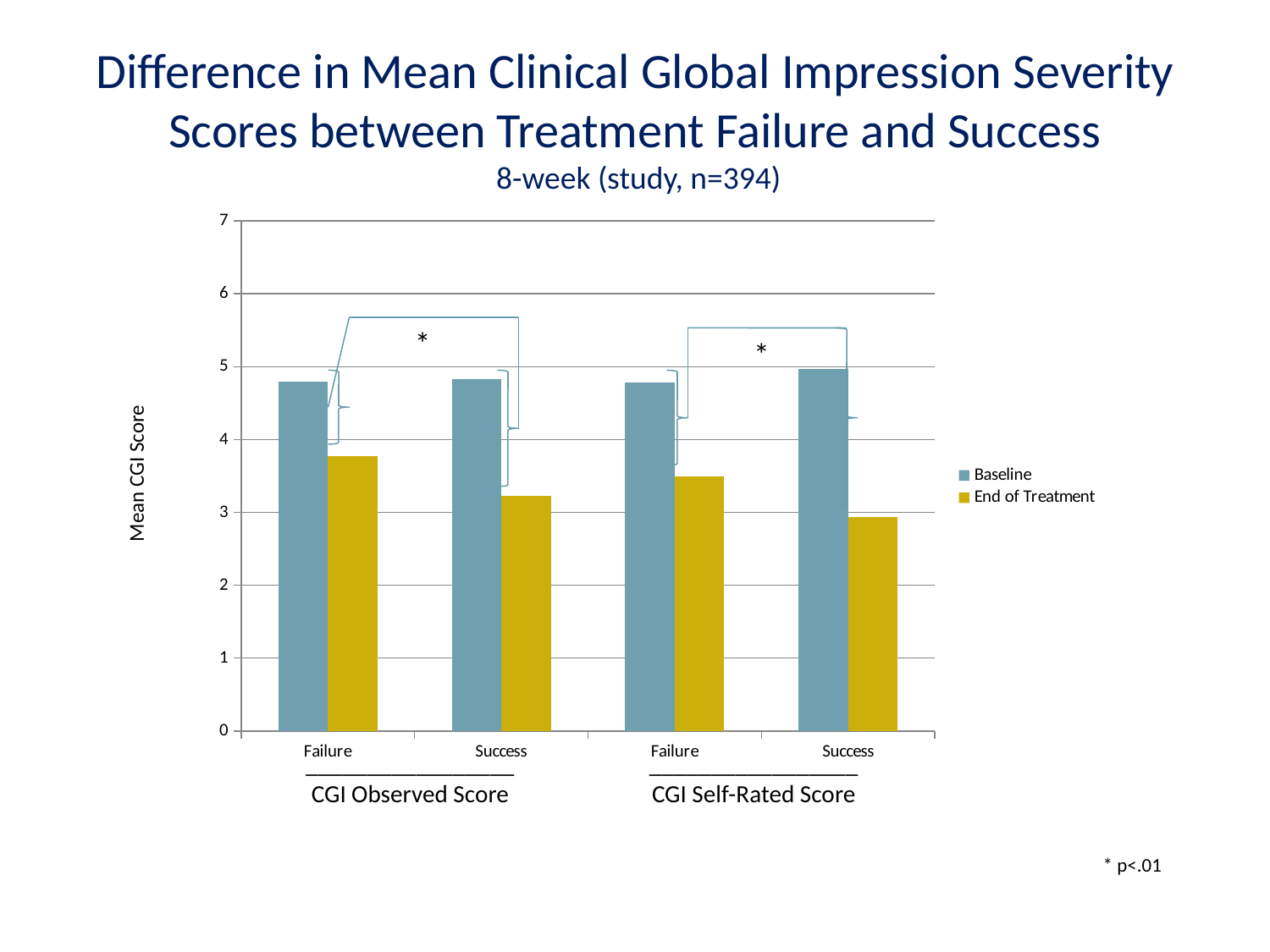
What are the two series named in the legend? Baseline and End of Treatment How many series does the legend list? 2 What kind of chart is shown on the slide? bar chart Is the End of Treatment value for Failure under CGI Self-Rated Score greater or less than 3? greater Is the End of Treatment value for Success under CGI Observed Score greater or less than 4? less How many category groups (pairs of bars) are plotted on the x axis? 4 Is the Baseline value for Failure under CGI Observed Score greater or less than 4? greater Under CGI Self-Rated Score, which has the larger End of Treatment value, Failure or Success? Failure Which bar has the lowest End of Treatment value across all groups? Success under CGI Self-Rated Score What is the label of the y axis? Mean CGI Score Under CGI Observed Score, which has the larger End of Treatment value, Failure or Success? Failure